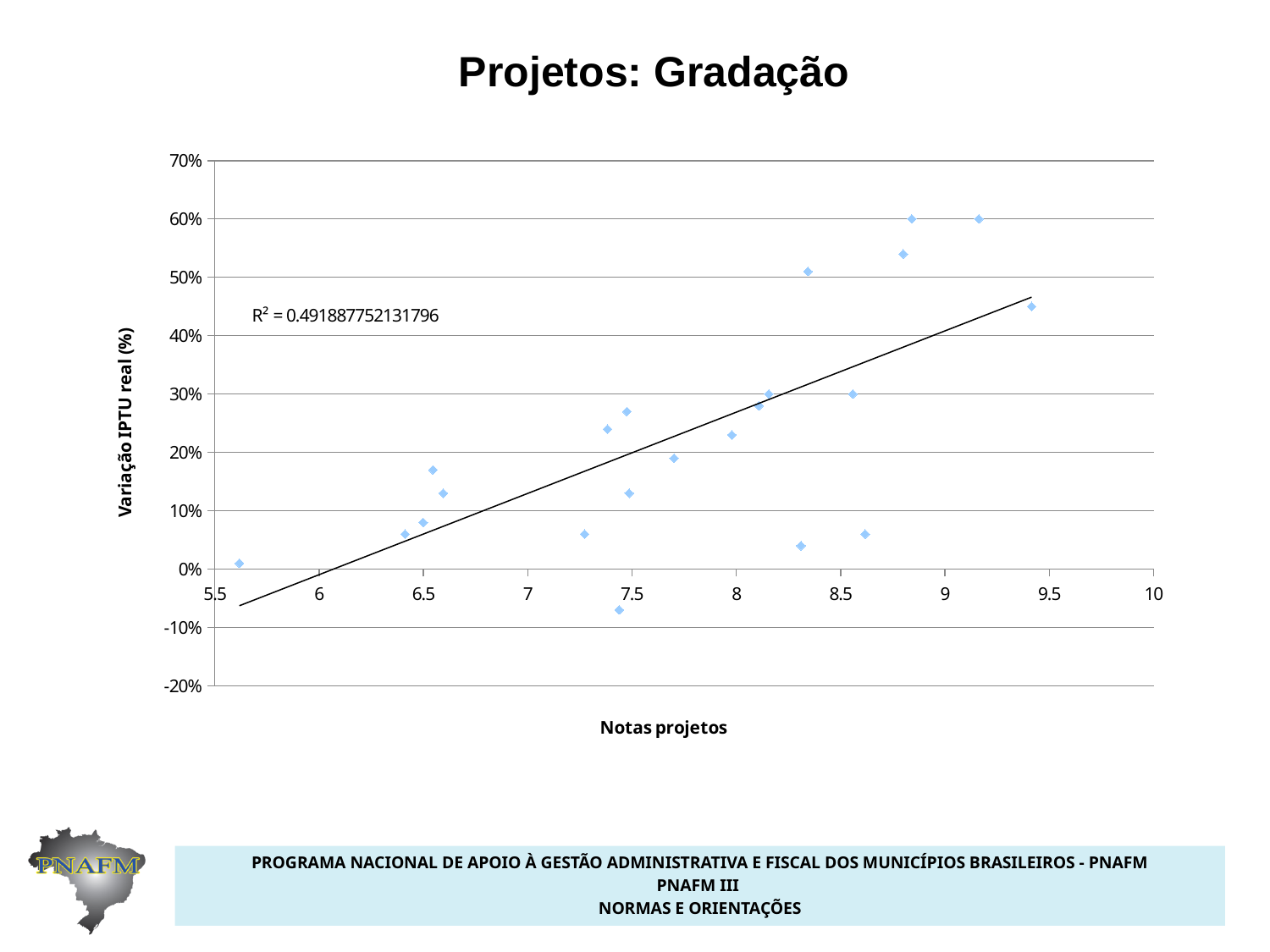
Is the lowest plotted point on the chart greater or less than 0%? less What is the title of the chart on the slide? Projetos: Gradação What R² value is printed on the chart? R² = 0.491887752131796 Which is larger: the Variação IPTU real for the point near Notas projetos 9.15 or the point near Notas projetos 9.4? the point near 9.15 Is the value for the point with the lowest Notas projetos (around 5.6) greater or less than 10%? less What is the highest value shown on the y axis? 70% What kind of chart is shown on the slide? scatter chart Do the values of Variação IPTU real (%) generally rise or fall as Notas projetos increases along the x axis? rise Is the value for the point with the highest Notas projetos (around 9.4) greater or less than 40%? greater What is the label of the x axis? Notas projetos